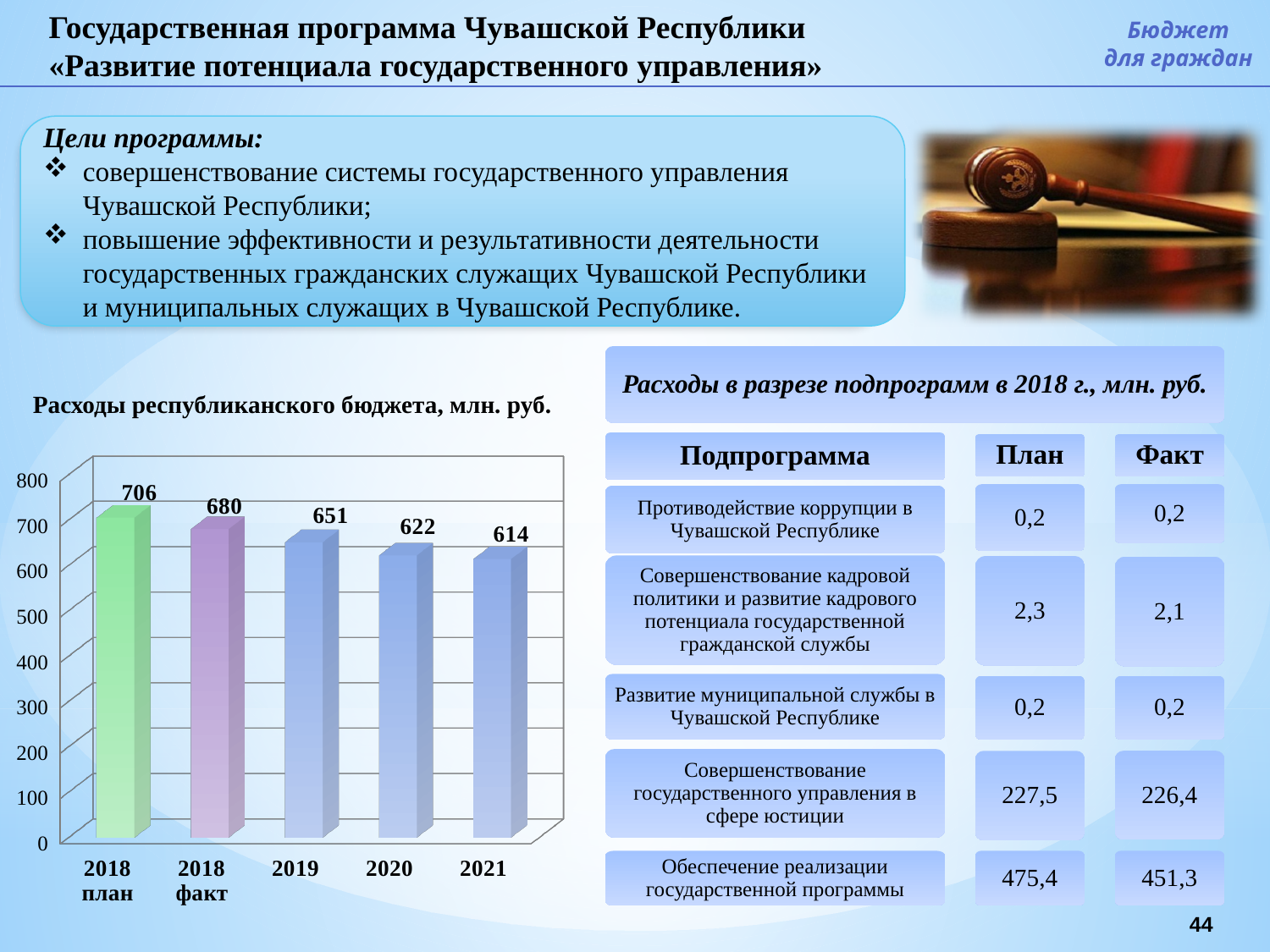
What is the value for 2018 факт in the chart 'Расходы республиканского бюджета, млн. руб.'? 680 What kind of chart is 'Расходы республиканского бюджета, млн. руб.'? bar chart What is the difference between the 2018 план and 2018 факт values in the chart 'Расходы республиканского бюджета, млн. руб.'? 26 How many bars are shown in the chart 'Расходы республиканского бюджета, млн. руб.'? 5 Which is larger in the chart 'Расходы республиканского бюджета, млн. руб.': the value for 2019 or the value for 2021? 2019 What is the value for 2021 in the chart 'Расходы республиканского бюджета, млн. руб.'? 614 What is the difference between the 2019 and 2020 values in the chart 'Расходы республиканского бюджета, млн. руб.'? 29 What is the value for 2018 план in the chart 'Расходы республиканского бюджета, млн. руб.'? 706 Do the values in the chart 'Расходы республиканского бюджета, млн. руб.' rise or fall from 2019 to 2021? fall Is the value for 2020 in the chart 'Расходы республиканского бюджета, млн. руб.' greater or less than 700? less Which category has the lowest value in the chart 'Расходы республиканского бюджета, млн. руб.'? 2021 Which category has the highest value in the chart 'Расходы республиканского бюджета, млн. руб.'? 2018 план